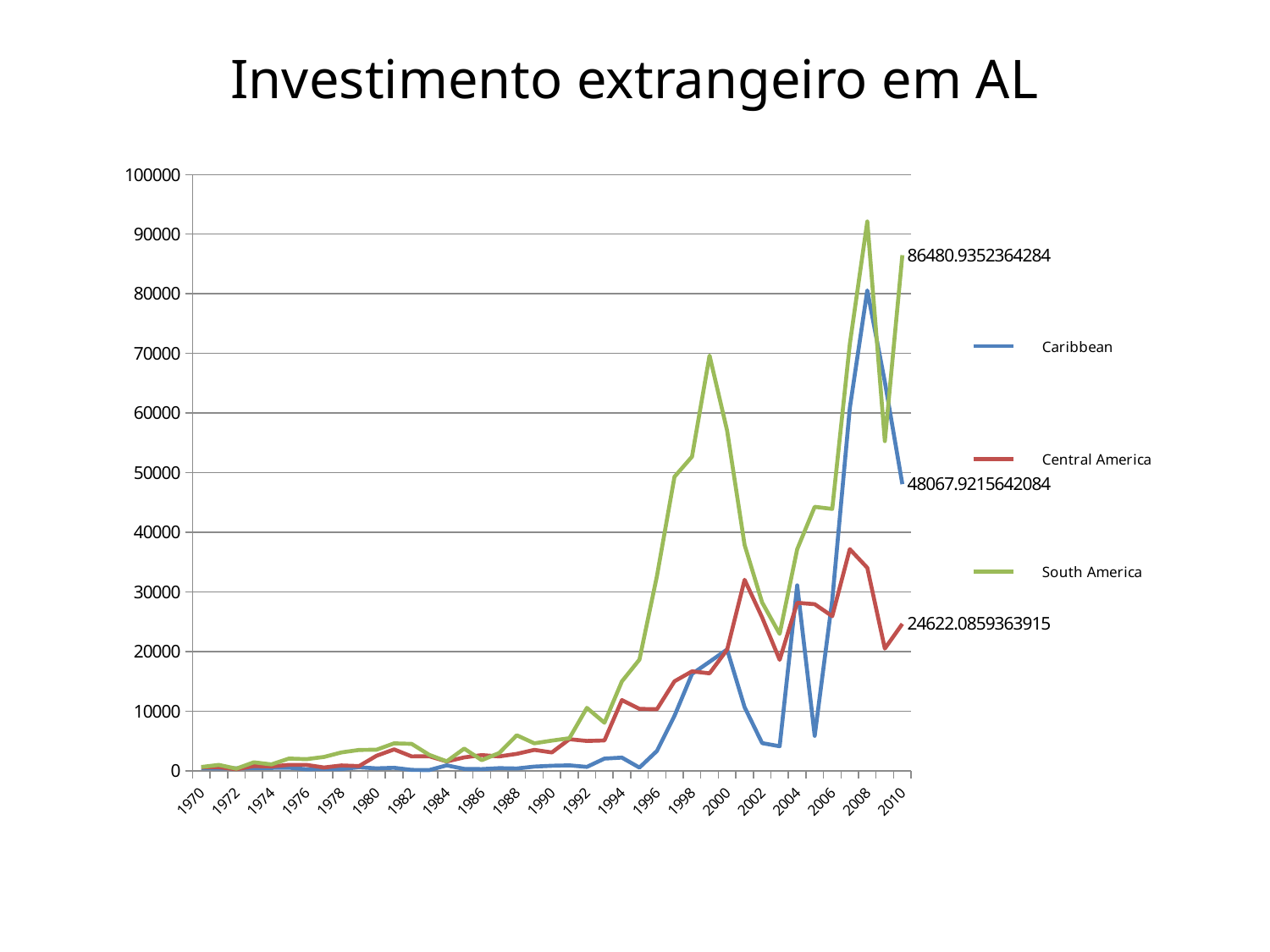
What kind of chart is shown on the slide? line chart What is the value for South America in 2010? 86480.9352364284 What is the title of the chart? Investimento extrangeiro em AL Is the value for Caribbean in 2005 greater or less than 10000? less Is the value for South America in 1999 greater or less than 60000? greater In 2010, which is larger: the value for Caribbean or the value for Central America? Caribbean What is the value for Caribbean in 2010? 48067.9215642084 Which series has the highest value in 2010? South America Is the value for South America in 2008 greater or less than 90000? greater What is the value for Central America in 2010? 24622.0859363915 Which series has the lowest value in 2010? Central America How many series does the legend list? 3